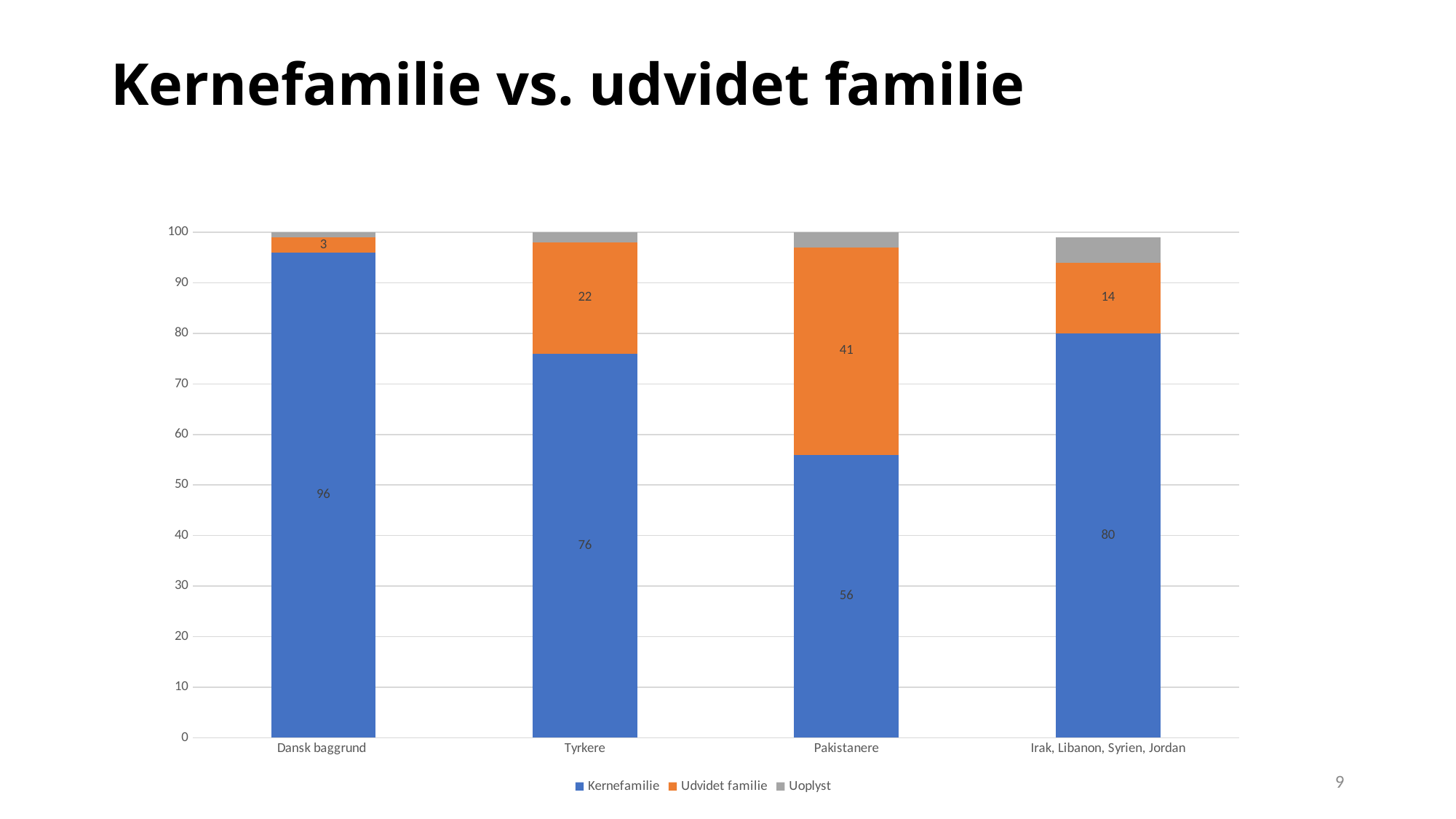
Which is larger: the Udvidet familie value for Pakistanere or for Irak, Libanon, Syrien, Jordan? Pakistanere What is the Kernefamilie value for Irak, Libanon, Syrien, Jordan? 80 How many series does the legend list? 3 Is the Kernefamilie value for Tyrkere greater or less than 70? greater Which category has the lowest Udvidet familie value? Dansk baggrund Which category has the highest Kernefamilie value? Dansk baggrund What is the difference between the Kernefamilie values for Dansk baggrund and Pakistanere? 40 What kind of chart is shown on the slide? Stacked bar chart What is the Kernefamilie value for Pakistanere? 56 What is the Udvidet familie value for Tyrkere? 22 What is the Udvidet familie value for Dansk baggrund? 3 How many categories are shown on the x axis? 4